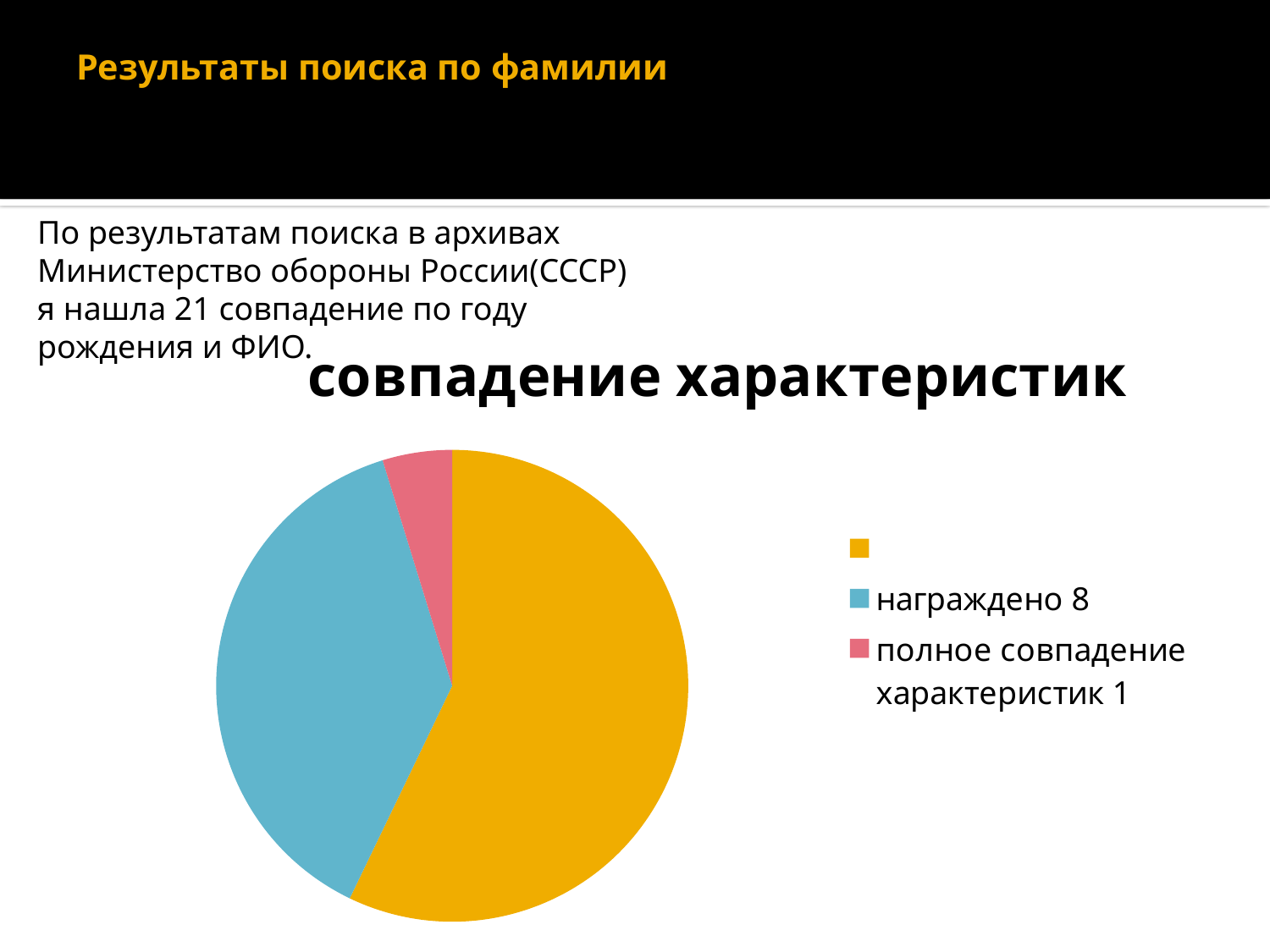
What kind of chart is shown on the slide? pie chart Which slice is larger: 'награждено 8' or 'полное совпадение характеристик 1'? награждено 8 Which slice of the pie chart is the smallest? полное совпадение характеристик 1 How many entries does the legend list? 3 Which slice is larger: the yellow slice or the blue 'награждено 8' slice? the yellow slice What colour is the 'награждено 8' slice in the pie chart? blue Is the share of the yellow slice greater or less than 50% of the pie? greater Is the share of the 'полное совпадение характеристик 1' slice greater or less than 25% of the pie? less How many slices does the pie chart have? 3 What is the title of the chart? совпадение характеристик Which slice of the pie chart is the largest? the yellow slice (unlabelled legend entry)